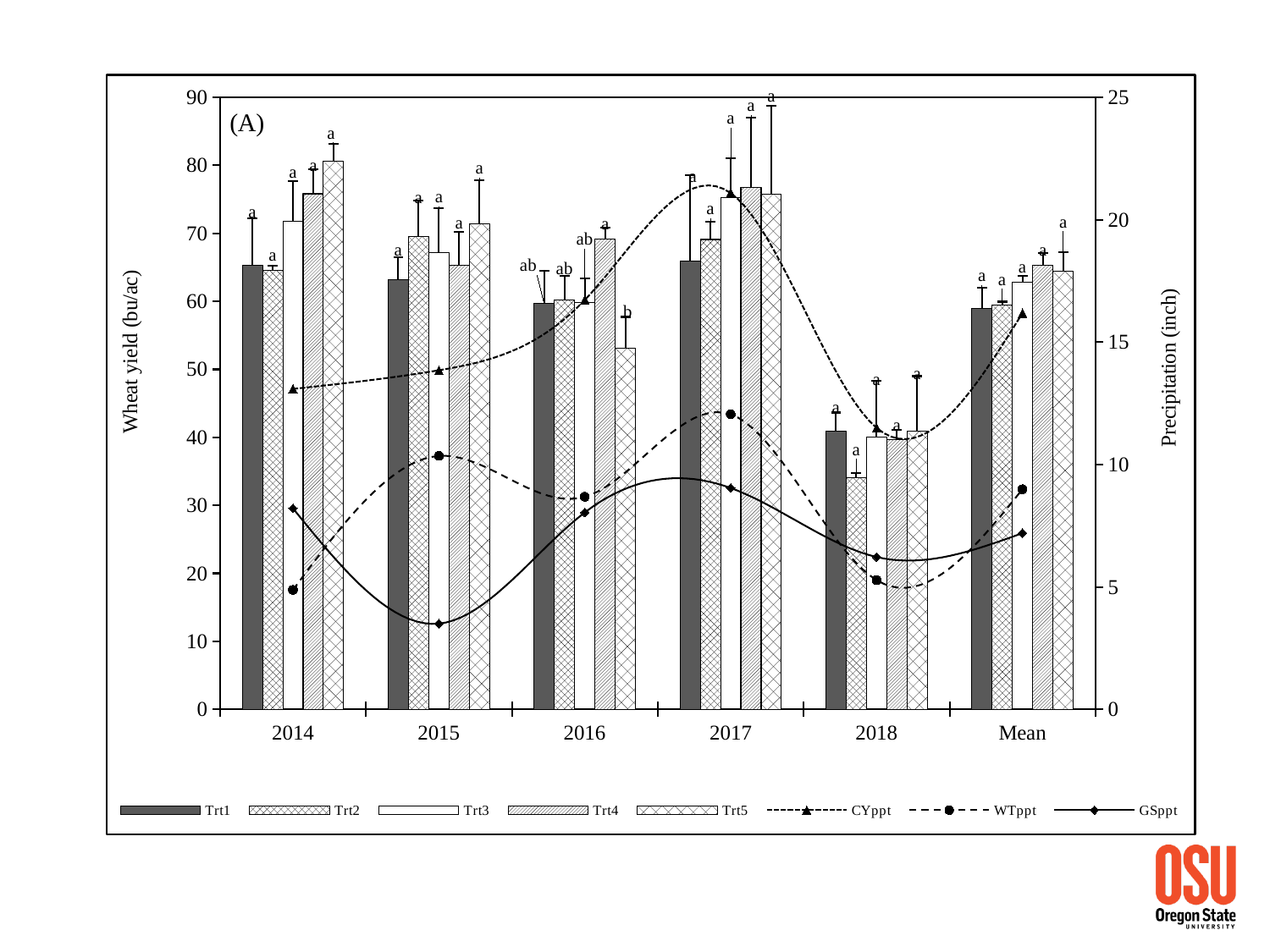
Is the wheat yield for Trt5 in 2016 greater or less than 60? less What is the title of the left vertical axis? Wheat yield (bu/ac) Is the CYppt precipitation value in 2017 greater or less than 20 inches? greater Which treatment has the highest wheat yield in 2014? Trt5 How many categories are shown on the x axis? 6 Which is larger, the Trt1 wheat yield in 2014 or in 2018? 2014 What is the title of the right vertical axis? Precipitation (inch) How many series does the legend list? 8 Is the wheat yield for Trt1 in 2014 greater or less than 60? greater Which treatment has the lowest wheat yield in 2016? Trt5 What kind of chart is shown on the slide? Combined bar and line chart